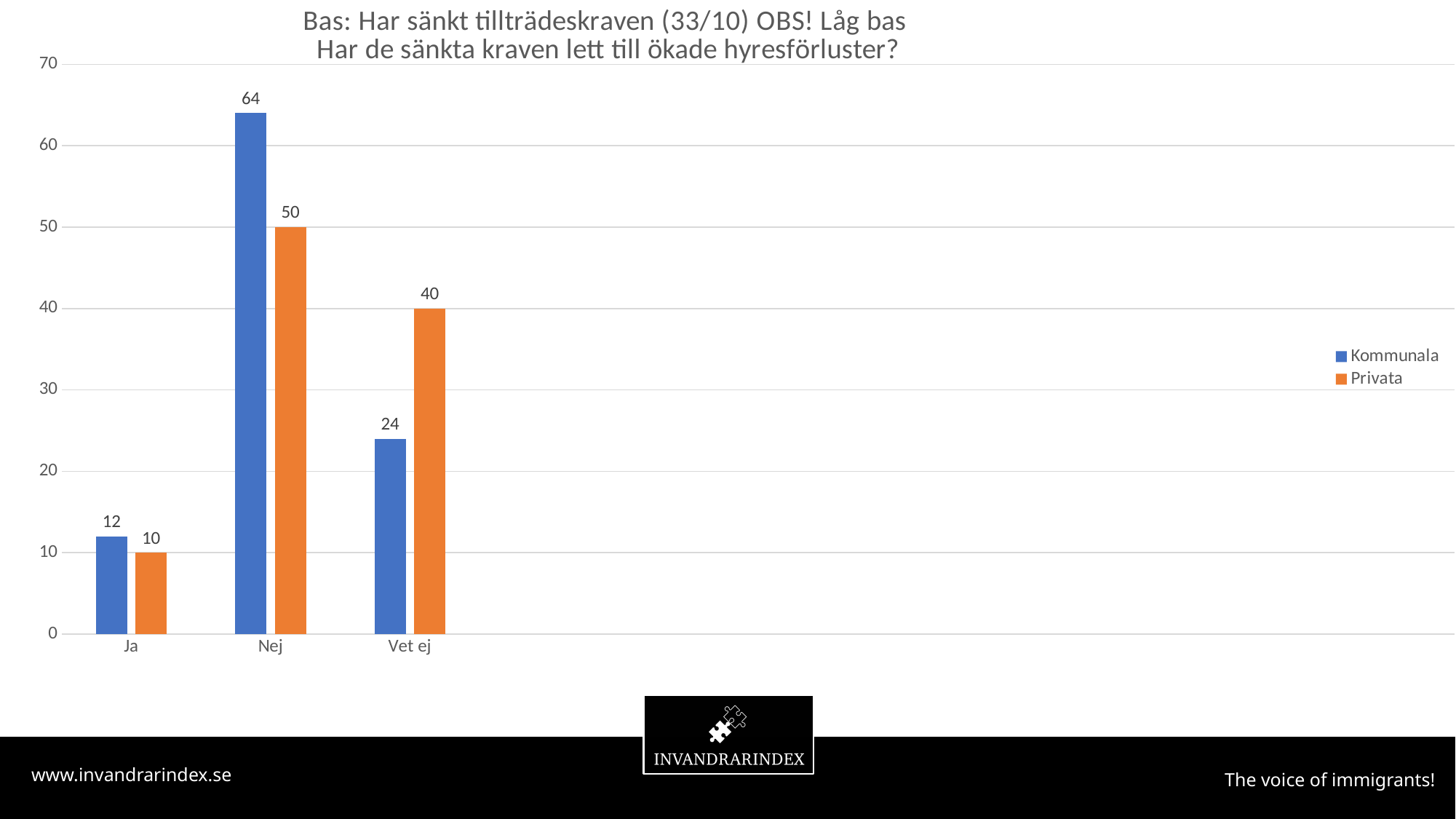
Is the value for Kommunala in the Nej category greater or less than 60? greater What is the difference between the Kommunala and Privata values in the Nej category? 14 How many categories are shown on the x axis? 3 What is the value for Privata in the Ja category? 10 Which category has the lowest value for the Privata series? Ja What is the value for Privata in the Vet ej category? 40 How many series does the legend list? 2 What kind of chart is shown on the slide? Bar chart In the Vet ej category, which series has the larger value, Kommunala or Privata? Privata Which category has the highest value for the Kommunala series? Nej Which colour represents the Privata series? Orange What is the value for Kommunala in the Nej category? 64